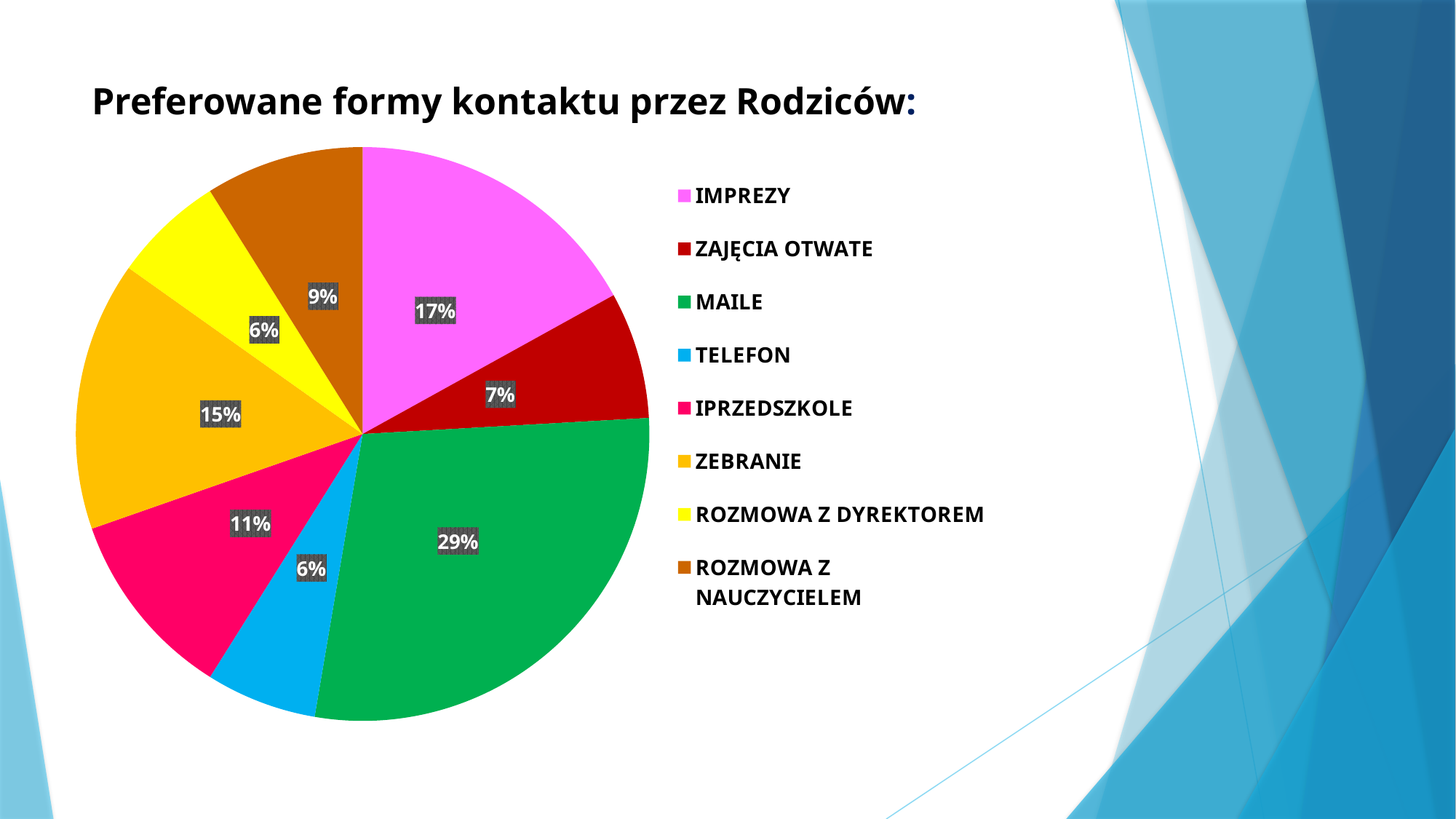
What is the title of the slide above the chart? Preferowane formy kontaktu przez Rodziców: What share of the pie does ROZMOWA Z NAUCZYCIELEM have? 9% What share of the pie does MAILE have? 29% Which category has the largest share of the pie? MAILE What is the difference between the shares of MAILE and IMPREZY? 12% What share of the pie does ZEBRANIE have? 15% How many categories does the pie chart show? 8 Which has a larger share, ZEBRANIE or IPRZEDSZKOLE? ZEBRANIE What kind of chart is shown on the slide? pie chart